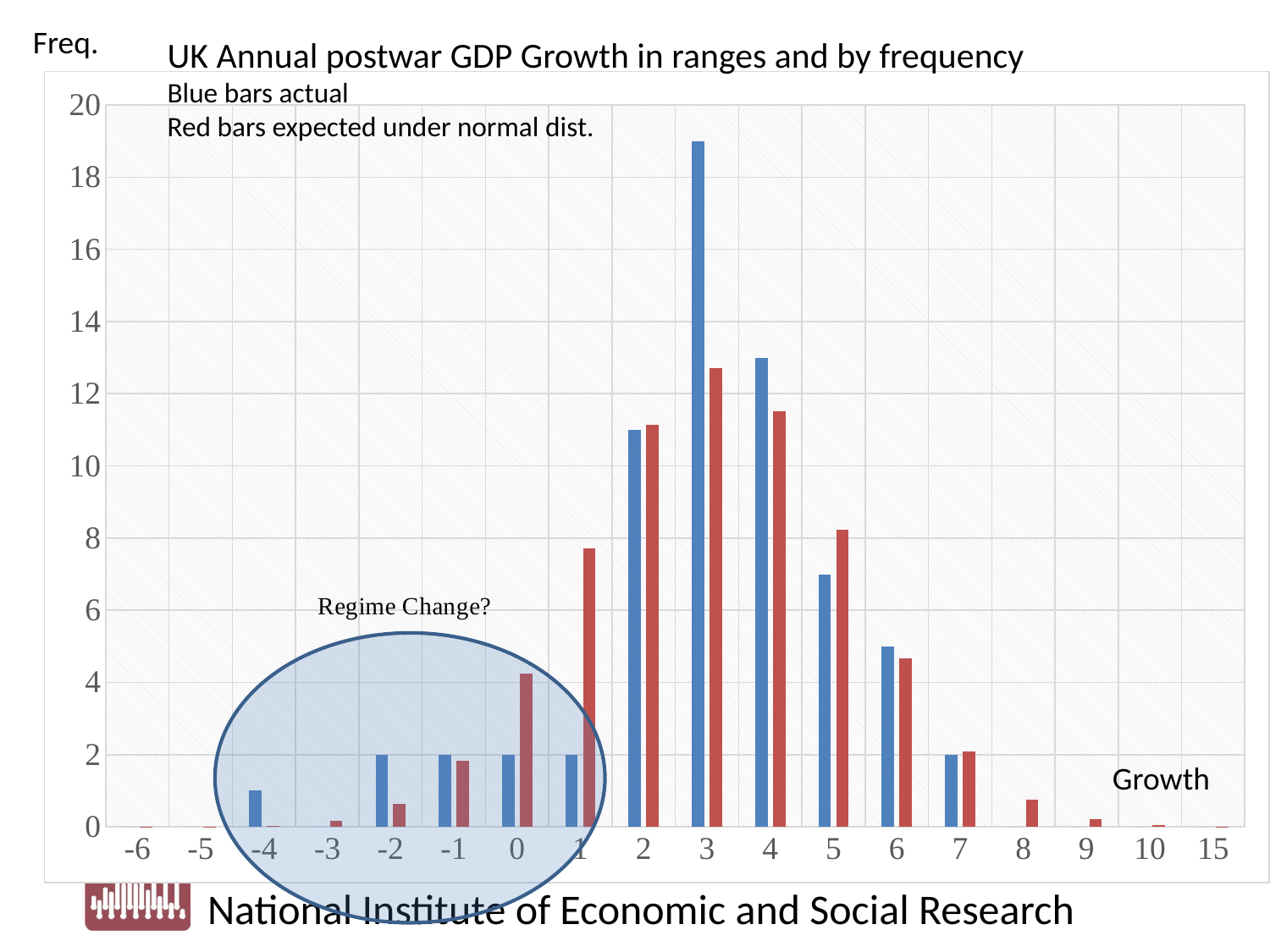
For growth of 3, which bar is taller, the blue (actual) or the red (expected)? blue (actual) Is the actual (blue) frequency for growth of 3 greater or less than 18? greater What kind of chart is shown on the slide? bar chart Is the expected (red) frequency for growth of 1 greater or less than 8? less For growth of 1, which bar is taller, the blue (actual) or the red (expected)? red (expected) What is the actual (blue) frequency for growth of -2? 2 How many growth categories are shown on the x axis? 18 What is the title of the chart? UK Annual postwar GDP Growth in ranges and by frequency According to the note on the chart, what do the red bars represent? expected under normal dist. At which growth value is the blue (actual) bar highest? 3 At which growth value is the red (expected) bar highest? 3 What is the actual (blue) frequency for growth of 7? 2